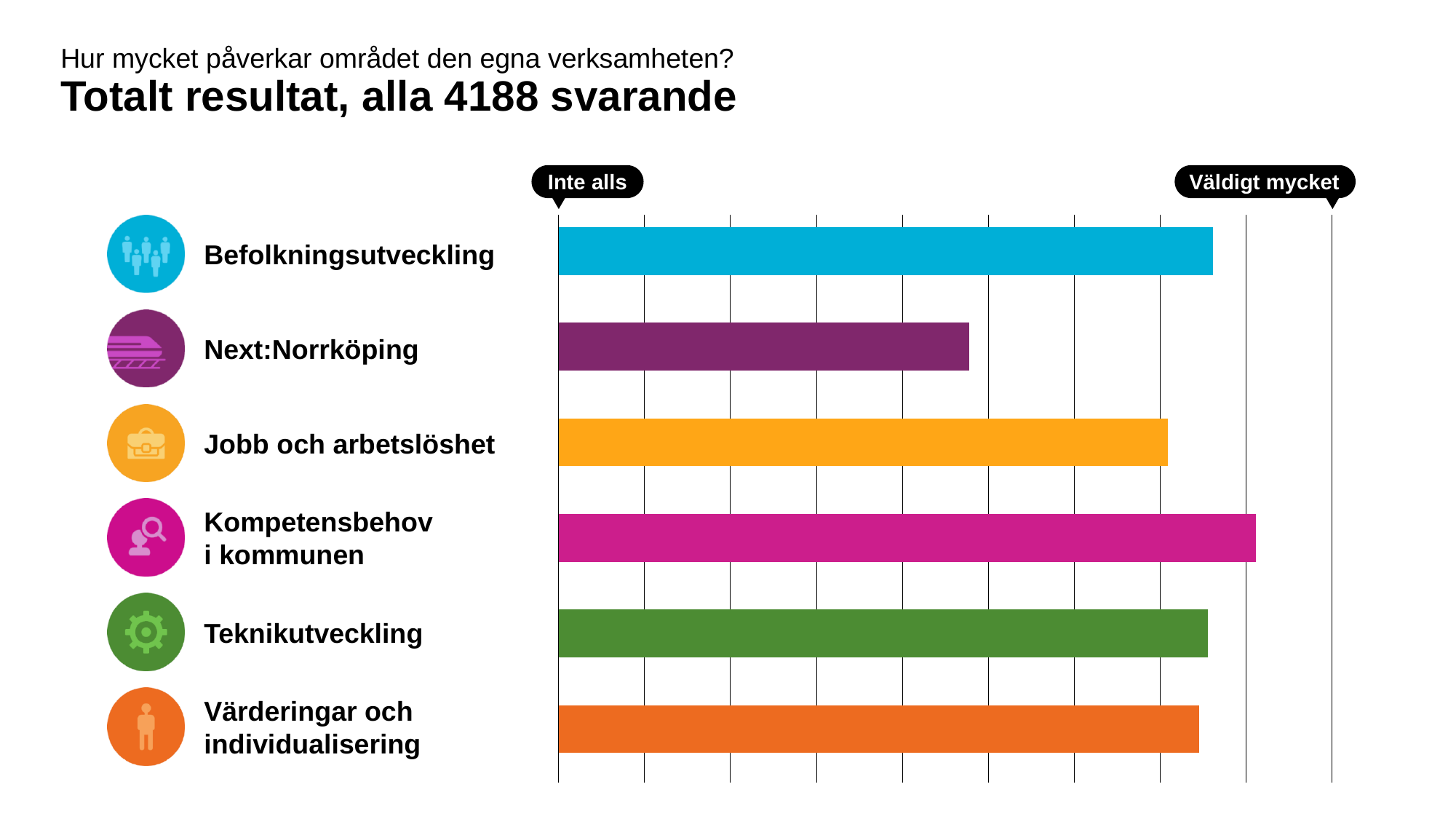
Which bar is longer: Next:Norrköping or Jobb och arbetslöshet? Jobb och arbetslöshet Which bar is longer: Befolkningsutveckling or Jobb och arbetslöshet? Befolkningsutveckling Which bar is longer: Kompetensbehov i kommunen or Teknikutveckling? Kompetensbehov i kommunen What label marks the right end of the chart's scale? Väldigt mycket What label marks the left end of the chart's scale? Inte alls Which category has the longest bar in the chart? Kompetensbehov i kommunen Which category has the shortest bar in the chart? Next:Norrköping What kind of chart is shown on the slide? bar chart How many categories (areas) are plotted in the chart? 6